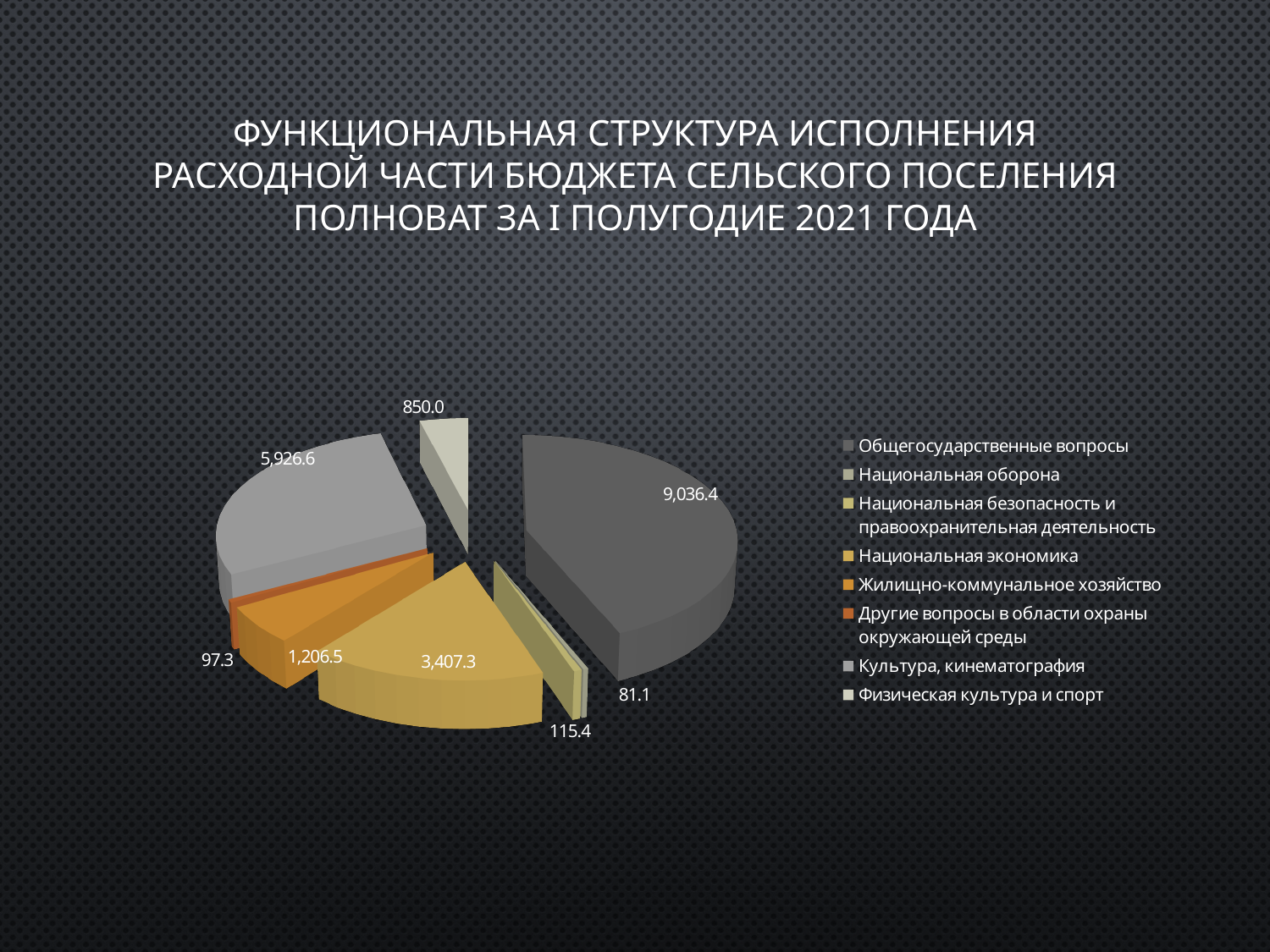
How many entries does the legend list? 8 Which is larger: Жилищно-коммунальное хозяйство or Национальная экономика? Национальная экономика Which category has the smallest slice of the pie? Национальная оборона Which category has the largest slice of the pie? Общегосударственные вопросы What is the value for Культура, кинематография? 5,926.6 What is the difference between the values for Общегосударственные вопросы and Культура, кинематография? 3,109.8 What is the value for Национальная экономика? 3,407.3 What is the difference between the values for Национальная безопасность и правоохранительная деятельность and Национальная оборона? 34.3 What kind of chart is shown on the slide? pie chart How many slices does the pie chart have? 8 What is the value for Общегосударственные вопросы? 9,036.4 What is the value for Физическая культура и спорт? 850.0